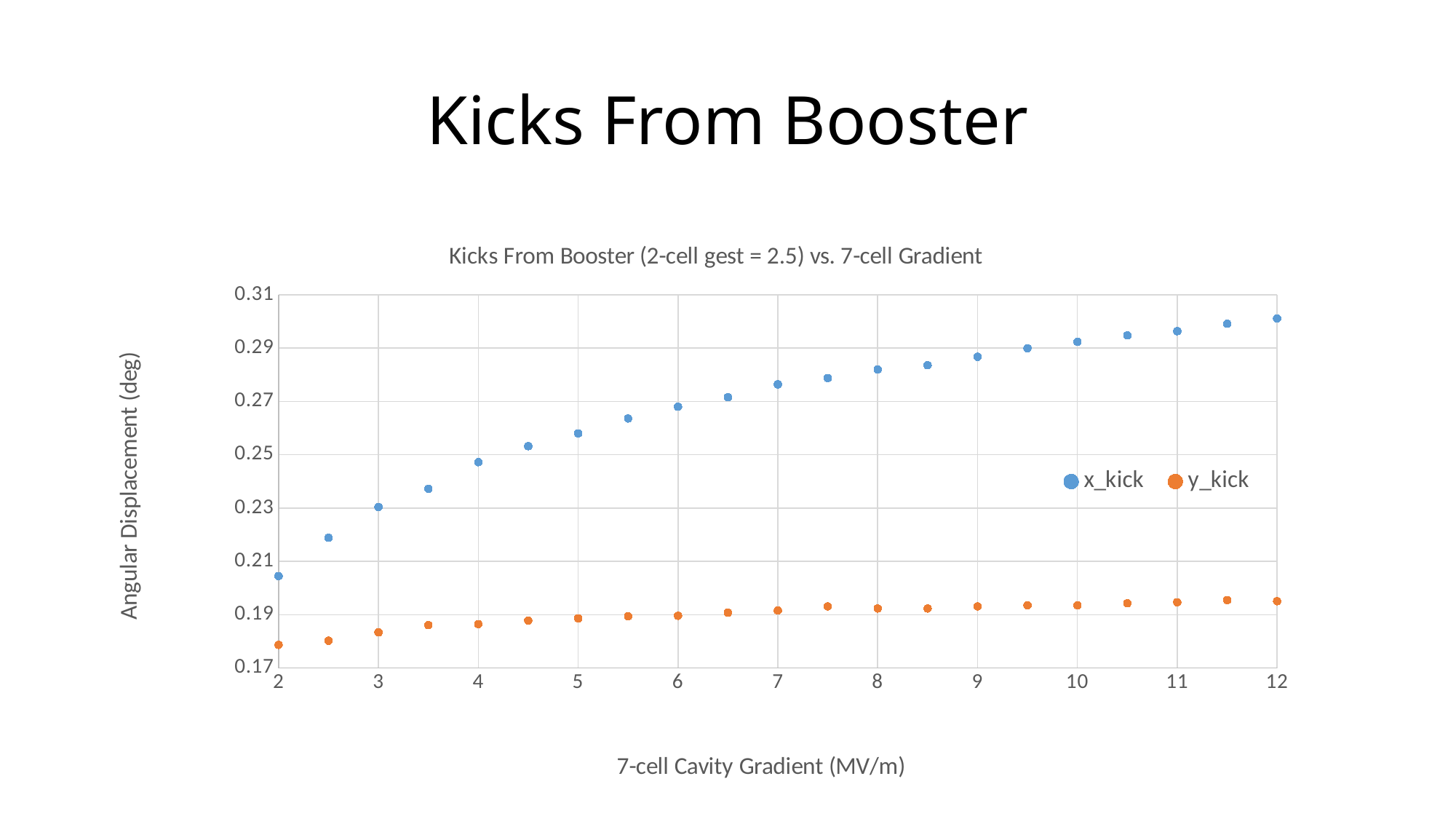
Do the x_kick values rise or fall as the 7-cell cavity gradient increases? rise At which 7-cell cavity gradient is the y_kick value lowest? 2 What are the names of the two series in the legend? x_kick and y_kick Is the x_kick value at a gradient of 12 greater or less than 0.29? greater How many data points are plotted for the x_kick series? 21 At a gradient of 8 MV/m, which series has the larger value, x_kick or y_kick? x_kick How many series does the legend list? 2 What kind of chart is shown on the slide? scatter chart Is the y_kick value at a gradient of 2 greater or less than 0.19? less Do the y_kick values rise or fall as the 7-cell cavity gradient increases? rise At which 7-cell cavity gradient is the x_kick value highest? 12 What is the label of the x axis? 7-cell Cavity Gradient (MV/m)